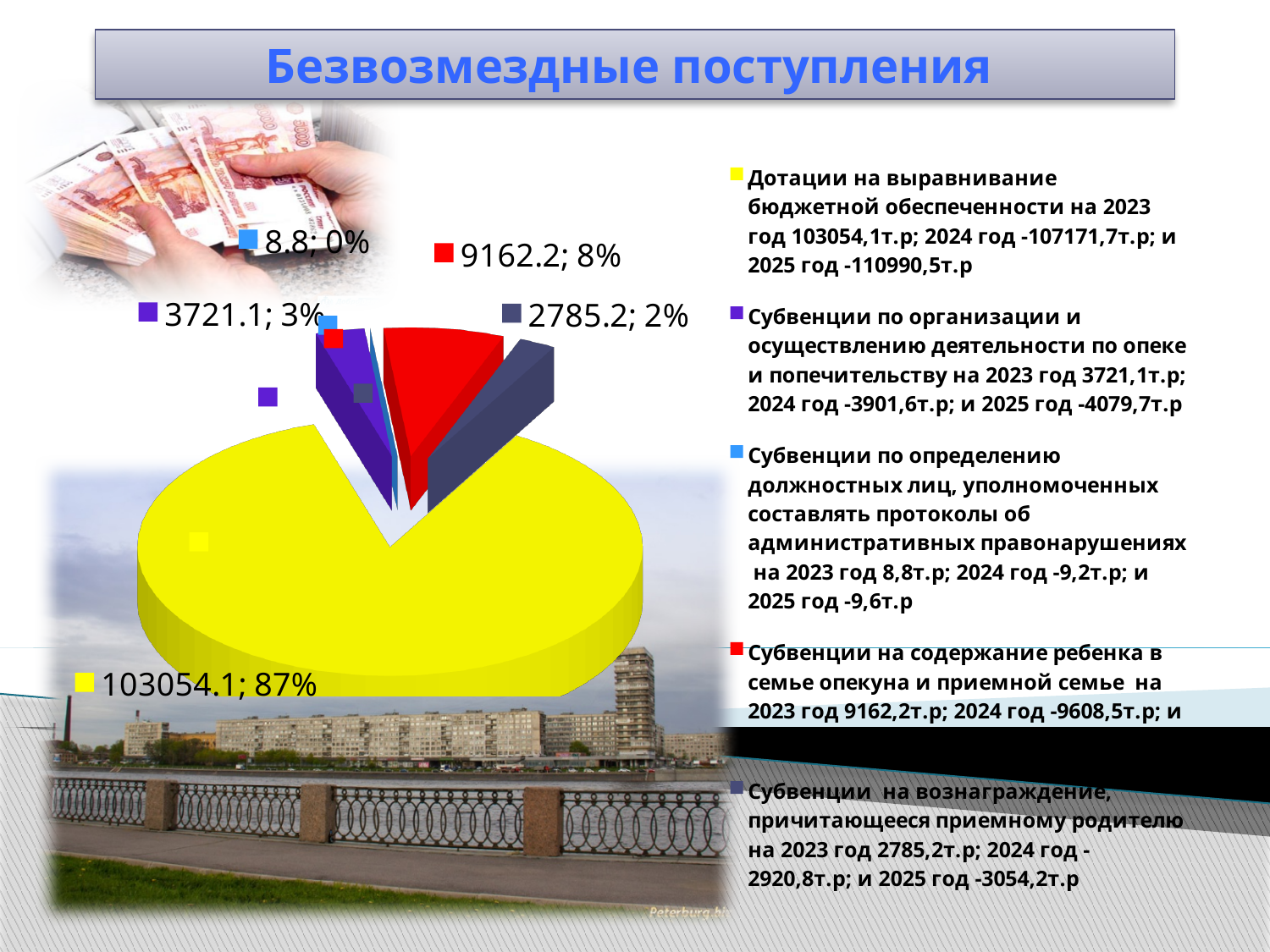
What share of the pie does the slice labelled 103054.1 represent? 87% What kind of chart is shown on the slide? Pie chart What is the value of the smallest slice of the pie chart? 8.8 How many slices does the pie chart have? 5 What is the value of the slice with a 3% share? 3721.1 What is the title of the slide containing the pie chart? Безвозмездные поступления Which category does the yellow slice of the pie chart represent? Дотации на выравнивание бюджетной обеспеченности Which slice is larger: the one labelled 2785.2 or the one labelled 3721.1? 3721.1 What is the difference between the slice labelled 9162.2 and the slice labelled 3721.1? 5441.1 What share of the pie does the slice labelled 9162.2 represent? 8% What is the value of the largest slice of the pie chart? 103054.1 What is the value of the slice with a 2% share? 2785.2